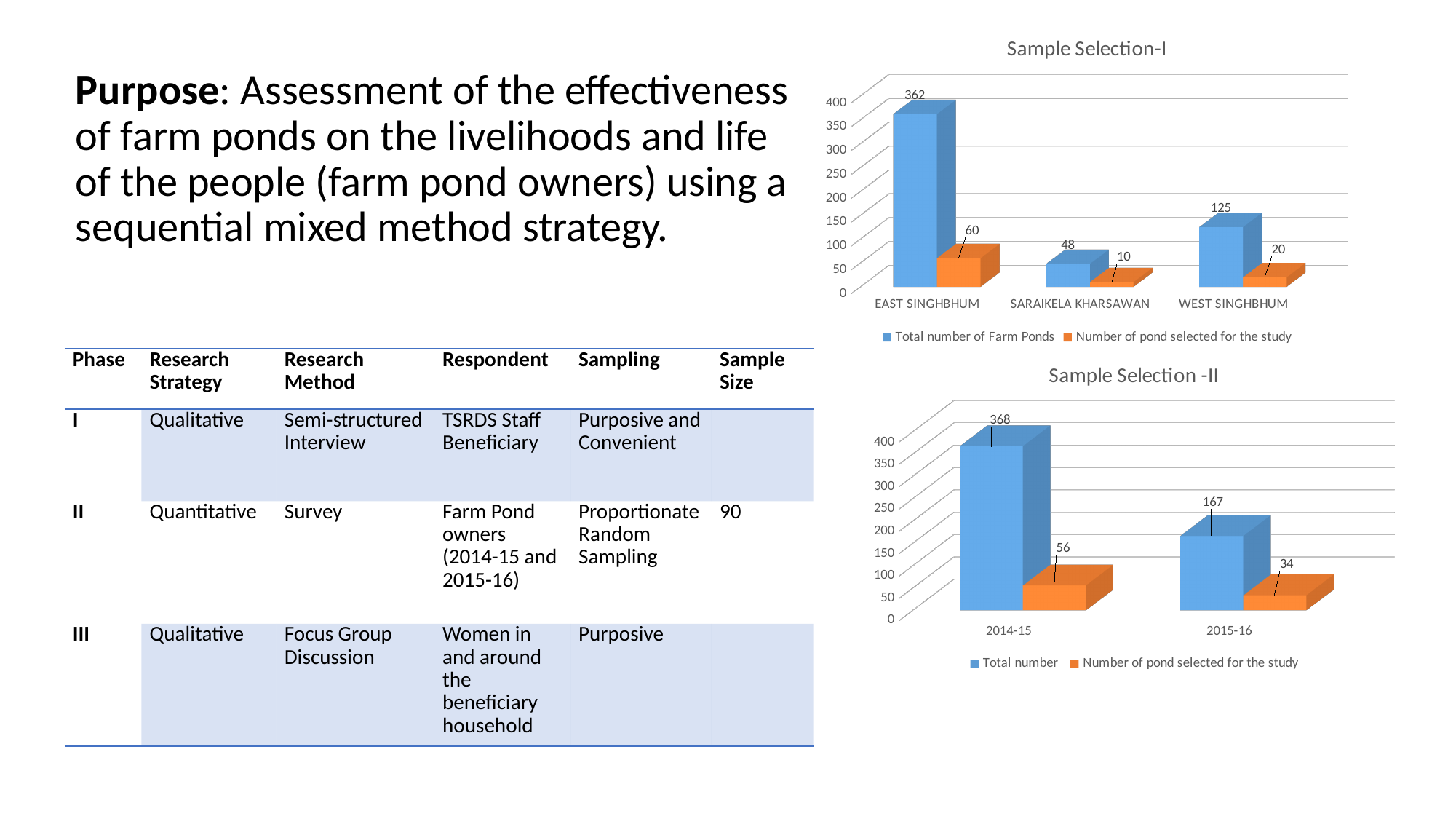
In the 'Sample Selection -II' chart, what is the total number for 2014-15? 368 In the 'Sample Selection -II' chart, what is the difference between the number of ponds selected for the study in 2014-15 and 2015-16? 22 In the 'Sample Selection-I' chart, which district has the lowest total number of farm ponds? SARAIKELA KHARSAWAN In the 'Sample Selection-I' chart, what is the difference between the total number of farm ponds in EAST SINGHBHUM and WEST SINGHBHUM? 237 What kind of chart is 'Sample Selection -II'? bar chart In the 'Sample Selection -II' chart, how many ponds were selected for the study in 2015-16? 34 In the 'Sample Selection-I' chart, which district has the highest number of ponds selected for the study? EAST SINGHBHUM In the 'Sample Selection-I' chart, how many series does the legend list? 2 In the 'Sample Selection-I' chart, how many districts are shown on the x axis? 3 In the 'Sample Selection-I' chart, what is the total number of farm ponds for EAST SINGHBHUM? 362 In the 'Sample Selection-I' chart, how many ponds were selected for the study in WEST SINGHBHUM? 20 In the 'Sample Selection -II' chart, is the total number for 2015-16 larger or smaller than the total number for 2014-15? smaller